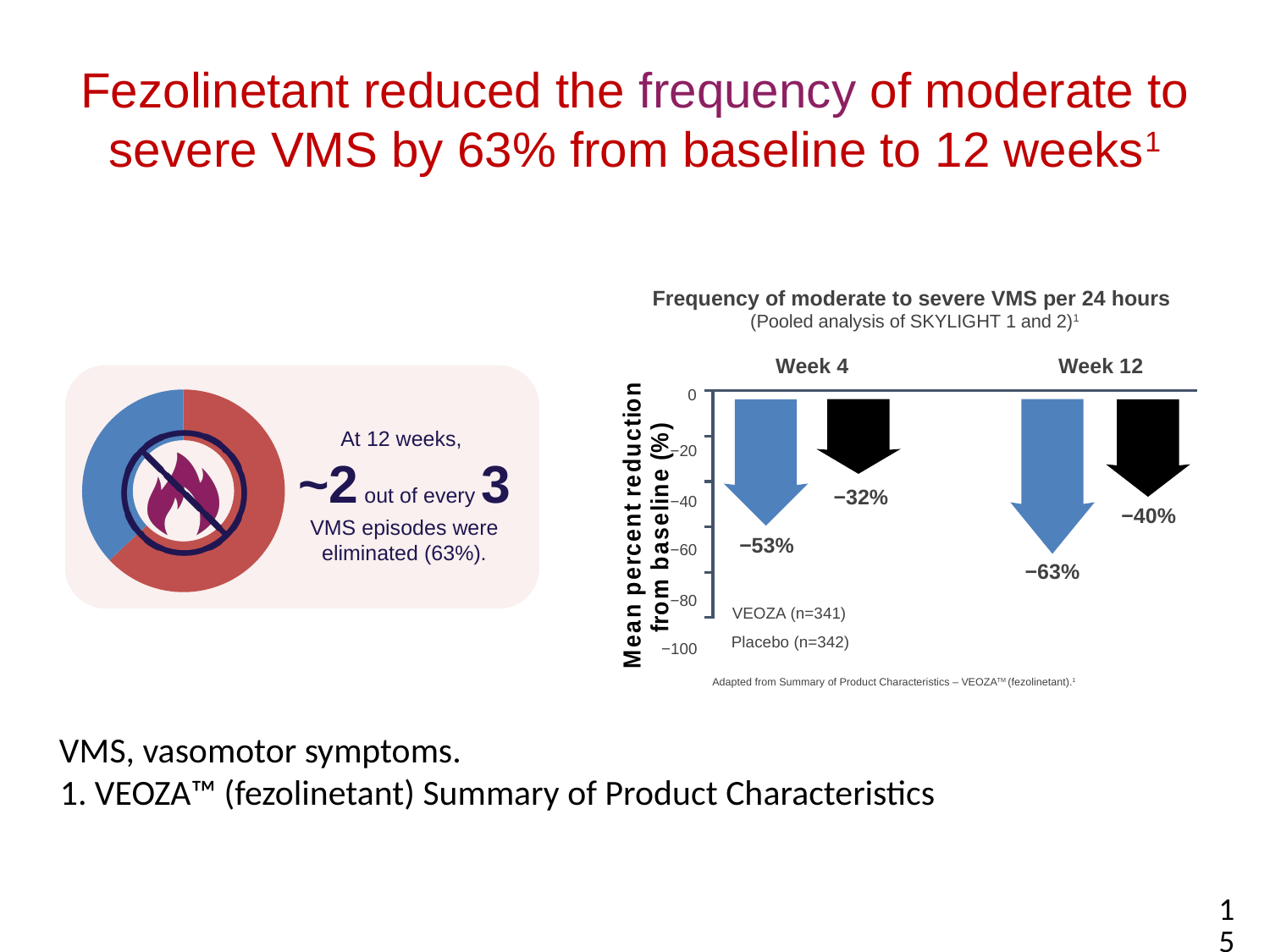
In the chart titled 'Frequency of moderate to severe VMS per 24 hours', how many groups does the legend list? 2 In the chart titled 'Frequency of moderate to severe VMS per 24 hours', what is the difference in percentage points between the VEOZA and Placebo reductions at Week 12? 23 percentage points In the chart titled 'Frequency of moderate to severe VMS per 24 hours', which group shows the largest percent reduction at Week 12? VEOZA In the chart titled 'Frequency of moderate to severe VMS per 24 hours', which group shows the smallest percent reduction at Week 4? Placebo In the chart titled 'Frequency of moderate to severe VMS per 24 hours', what is the mean percent reduction from baseline for Placebo at Week 12? −40% In the chart titled 'Frequency of moderate to severe VMS per 24 hours', is the reduction for VEOZA larger at Week 4 or at Week 12? Week 12 In the chart titled 'Frequency of moderate to severe VMS per 24 hours', what is the mean percent reduction from baseline for Placebo at Week 4? −32% In the chart titled 'Frequency of moderate to severe VMS per 24 hours', what is the sample size (n) for the VEOZA group shown in the legend? n=341 In the chart titled 'Frequency of moderate to severe VMS per 24 hours', what is the difference in percentage points between the VEOZA and Placebo reductions at Week 4? 21 percentage points In the chart titled 'Frequency of moderate to severe VMS per 24 hours', what is the mean percent reduction from baseline for VEOZA at Week 12? −63% In the chart titled 'Frequency of moderate to severe VMS per 24 hours', how many time points are shown on the x axis? 2 In the chart titled 'Frequency of moderate to severe VMS per 24 hours', what is the mean percent reduction from baseline for VEOZA at Week 4? −53%